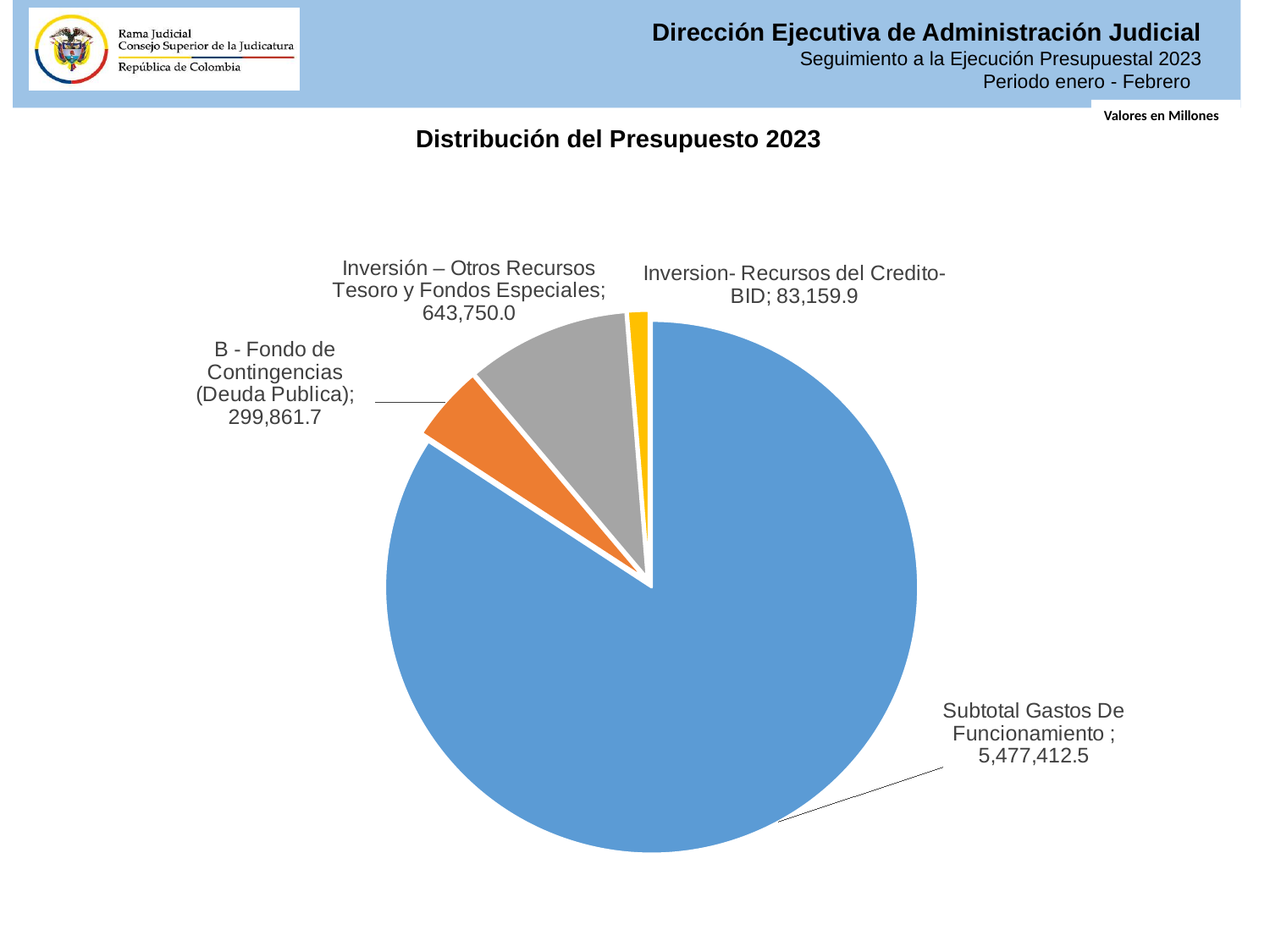
What colour is the slice for Subtotal Gastos De Funcionamiento? Blue Which is larger: Inversión – Otros Recursos Tesoro y Fondos Especiales or B - Fondo de Contingencias (Deuda Publica)? Inversión – Otros Recursos Tesoro y Fondos Especiales What is the difference between Inversión – Otros Recursos Tesoro y Fondos Especiales and B - Fondo de Contingencias (Deuda Publica)? 343,888.3 Which category has the largest slice of the pie? Subtotal Gastos De Funcionamiento What kind of chart is shown on the slide? Pie chart What is the value for Inversion- Recursos del Credito-BID? 83,159.9 What is the value for Inversión – Otros Recursos Tesoro y Fondos Especiales? 643,750.0 Which category has the smallest slice of the pie? Inversion- Recursos del Credito-BID What is the value for Subtotal Gastos De Funcionamiento? 5,477,412.5 How many slices does the pie chart have? 4 What is the title of the chart? Distribución del Presupuesto 2023 What is the value for B - Fondo de Contingencias (Deuda Publica)? 299,861.7